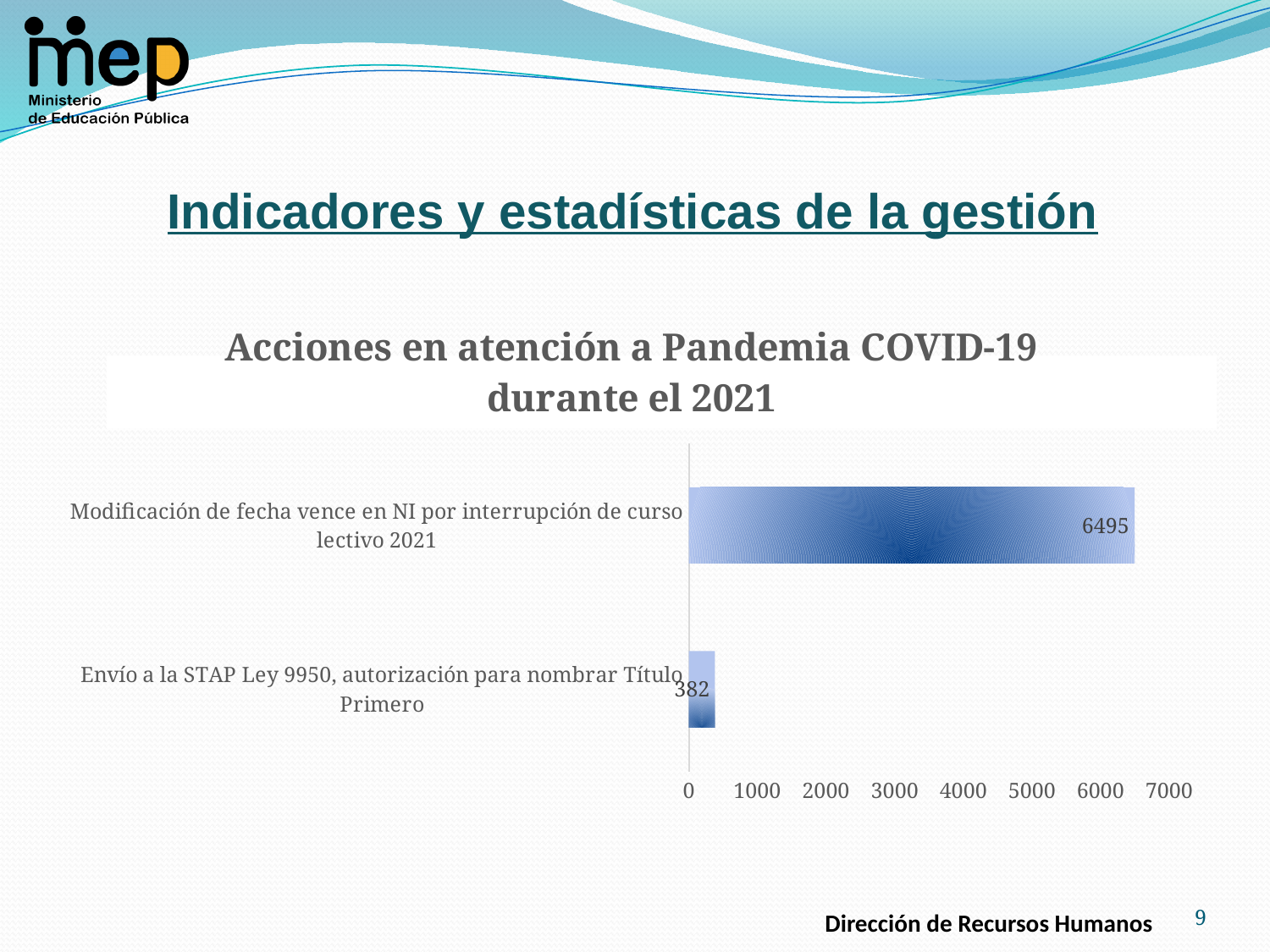
What is the value for 'Envío a la STAP Ley 9950, autorización para nombrar Título Primero'? 382 What kind of chart is shown on the slide? Bar chart How many categories are shown in the chart? 2 Is the value for 'Envío a la STAP Ley 9950, autorización para nombrar Título Primero' greater or less than 1000? less Which is larger: the value for 'Modificación de fecha vence en NI por interrupción de curso lectivo 2021' or the value for 'Envío a la STAP Ley 9950, autorización para nombrar Título Primero'? Modificación de fecha vence en NI por interrupción de curso lectivo 2021 What is the maximum value shown on the horizontal axis of the chart? 7000 Which category has the lowest value? Envío a la STAP Ley 9950, autorización para nombrar Título Primero Which category has the highest value? Modificación de fecha vence en NI por interrupción de curso lectivo 2021 What is the value for 'Modificación de fecha vence en NI por interrupción de curso lectivo 2021'? 6495 What is the difference between the value for 'Modificación de fecha vence en NI por interrupción de curso lectivo 2021' and the value for 'Envío a la STAP Ley 9950, autorización para nombrar Título Primero'? 6113 Is the value for 'Modificación de fecha vence en NI por interrupción de curso lectivo 2021' greater or less than 6000? greater What is the title of the chart? Acciones en atención a Pandemia COVID-19 durante el 2021